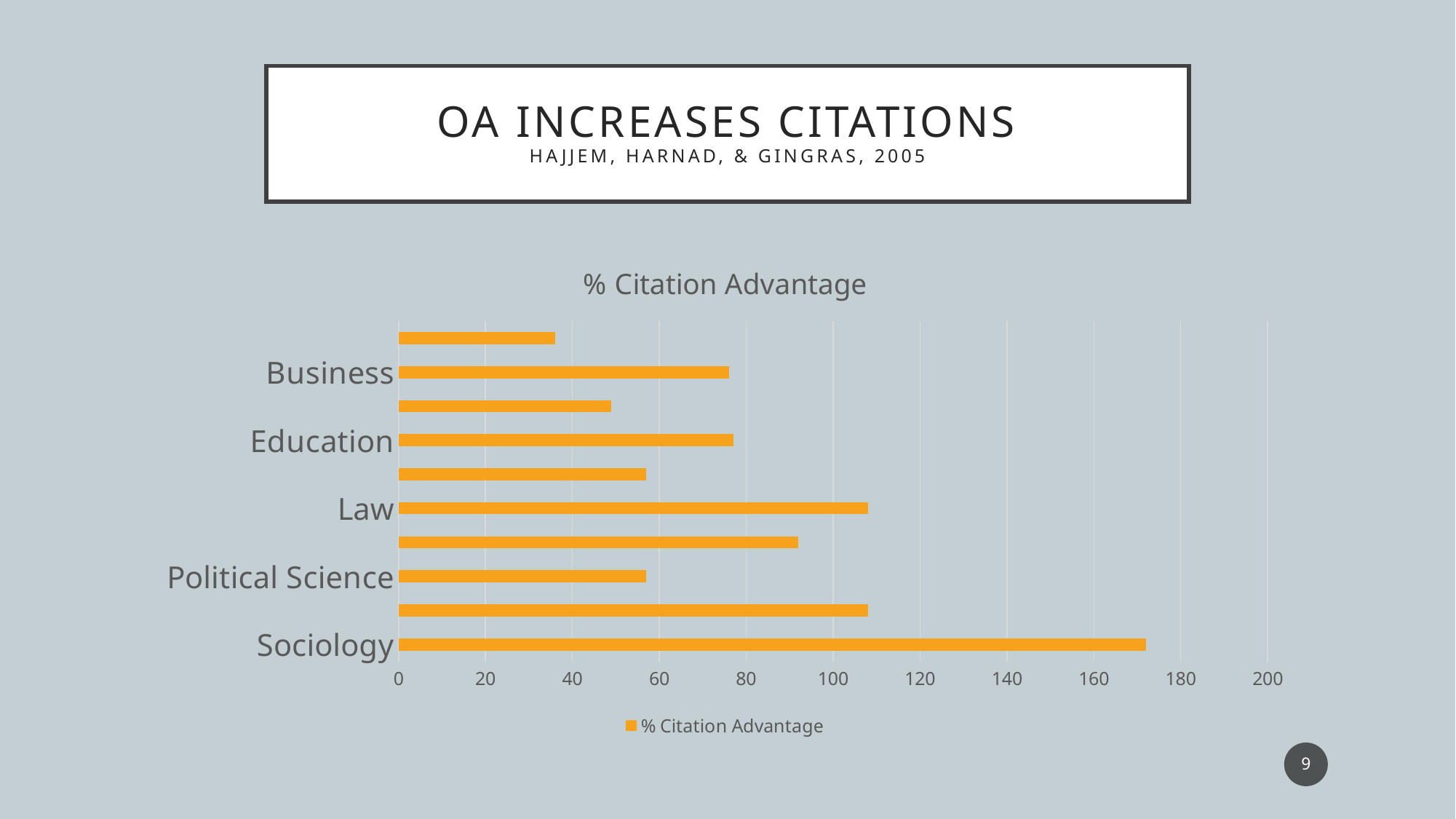
What kind of chart is shown on the slide? bar chart What is the title of the chart? % Citation Advantage Is the value for Political Science greater or less than 60? less Is the value for Business greater or less than 80? less Is the value for Sociology greater or less than 160? greater Which is larger, the value for Law or the value for Political Science? Law What is the highest value shown on the horizontal axis? 200 How many bars are plotted in the chart? 10 Which is larger, the value for Sociology or the value for Education? Sociology Which labelled category has the highest % Citation Advantage? Sociology How many series does the legend list? 1